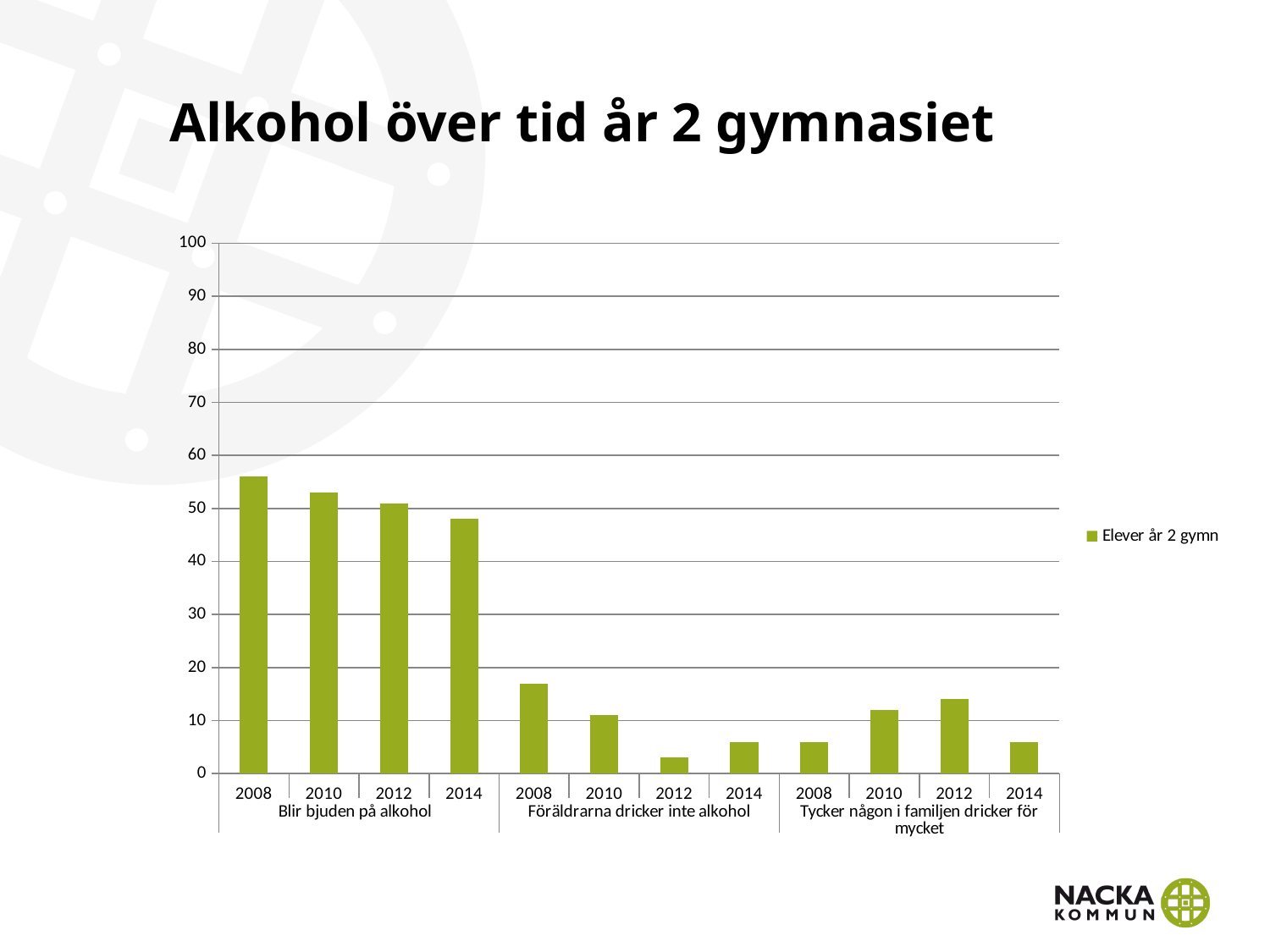
Which is larger: the 2008 value for 'Föräldrarna dricker inte alkohol' or the 2008 value for 'Tycker någon i familjen dricker för mycket'? Föräldrarna dricker inte alkohol How many series does the legend list? 1 What kind of chart is shown on the slide? Bar chart What is the name of the series in the legend? Elever år 2 gymn Which bar is the highest in the chart? 2008, Blir bjuden på alkohol How many bars are plotted in the chart? 12 What is the title of the chart on the slide? Alkohol över tid år 2 gymnasiet Is the value for 2008 under 'Blir bjuden på alkohol' greater or less than 50? greater Is the value for 2014 under 'Blir bjuden på alkohol' greater or less than 50? less Which bar is the lowest in the chart? 2012, Föräldrarna dricker inte alkohol Is the value for 2008 under 'Föräldrarna dricker inte alkohol' greater or less than 20? less Do the values for 'Blir bjuden på alkohol' rise or fall from 2008 to 2014? Fall